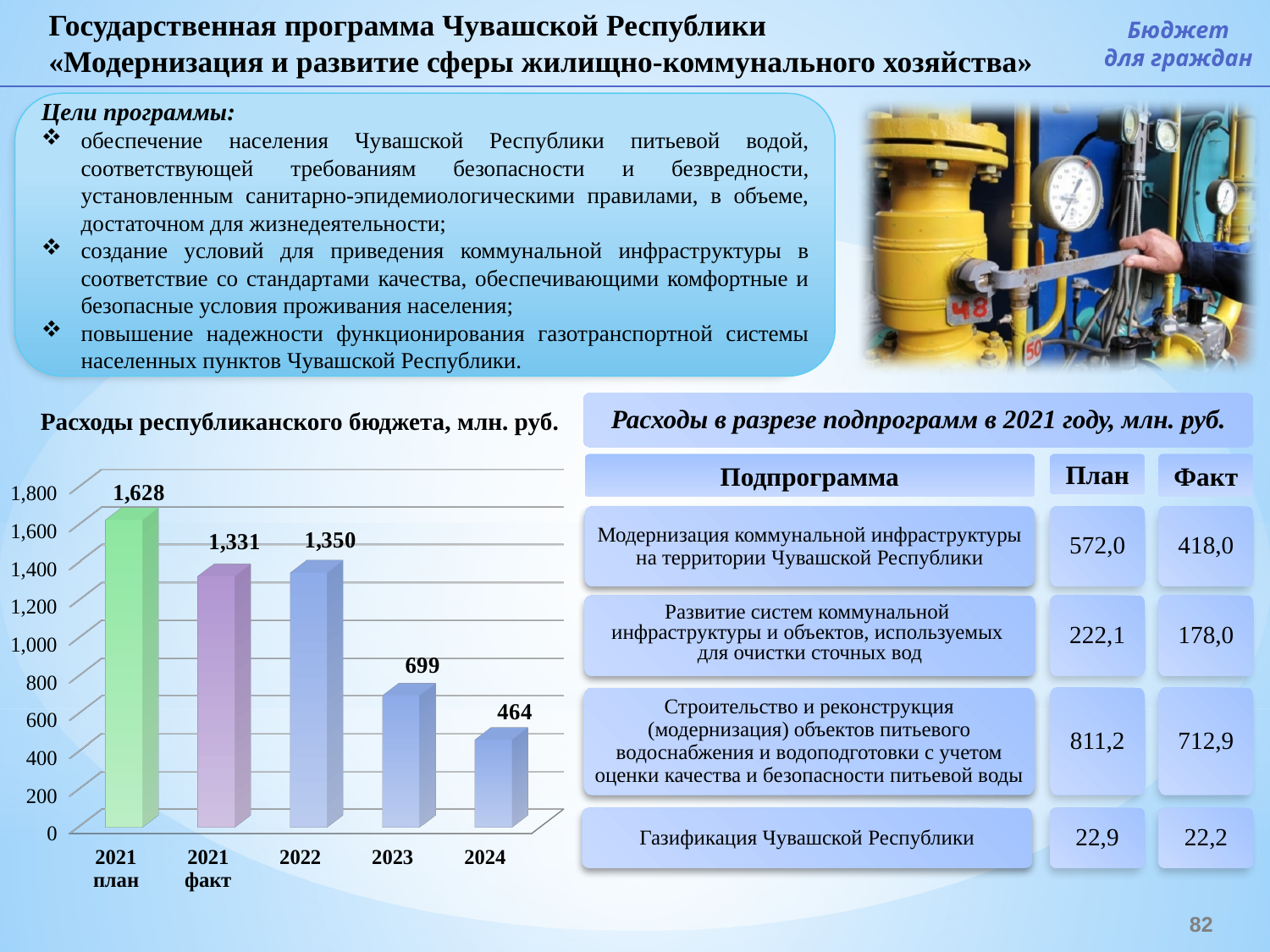
Which category has the highest value in the chart 'Расходы республиканского бюджета, млн. руб.'? 2021 план What is the value for 2021 план in the chart 'Расходы республиканского бюджета, млн. руб.'? 1,628 What kind of chart is 'Расходы республиканского бюджета, млн. руб.'? bar chart How many bars are shown in the chart 'Расходы республиканского бюджета, млн. руб.'? 5 In the chart 'Расходы республиканского бюджета, млн. руб.', which is larger: the value for 2022 or the value for 2023? 2022 In the chart 'Расходы республиканского бюджета, млн. руб.', do the values rise or fall from 2022 to 2024? fall What is the value for 2021 факт in the chart 'Расходы республиканского бюджета, млн. руб.'? 1,331 Is the value for 2023 in the chart 'Расходы республиканского бюджета, млн. руб.' greater or less than 800? less Which category has the lowest value in the chart 'Расходы республиканского бюджета, млн. руб.'? 2024 What is the difference between the 2023 and 2024 values in the chart 'Расходы республиканского бюджета, млн. руб.'? 235 What is the value for 2024 in the chart 'Расходы республиканского бюджета, млн. руб.'? 464 What is the difference between the 2021 план and 2021 факт values in the chart 'Расходы республиканского бюджета, млн. руб.'? 297